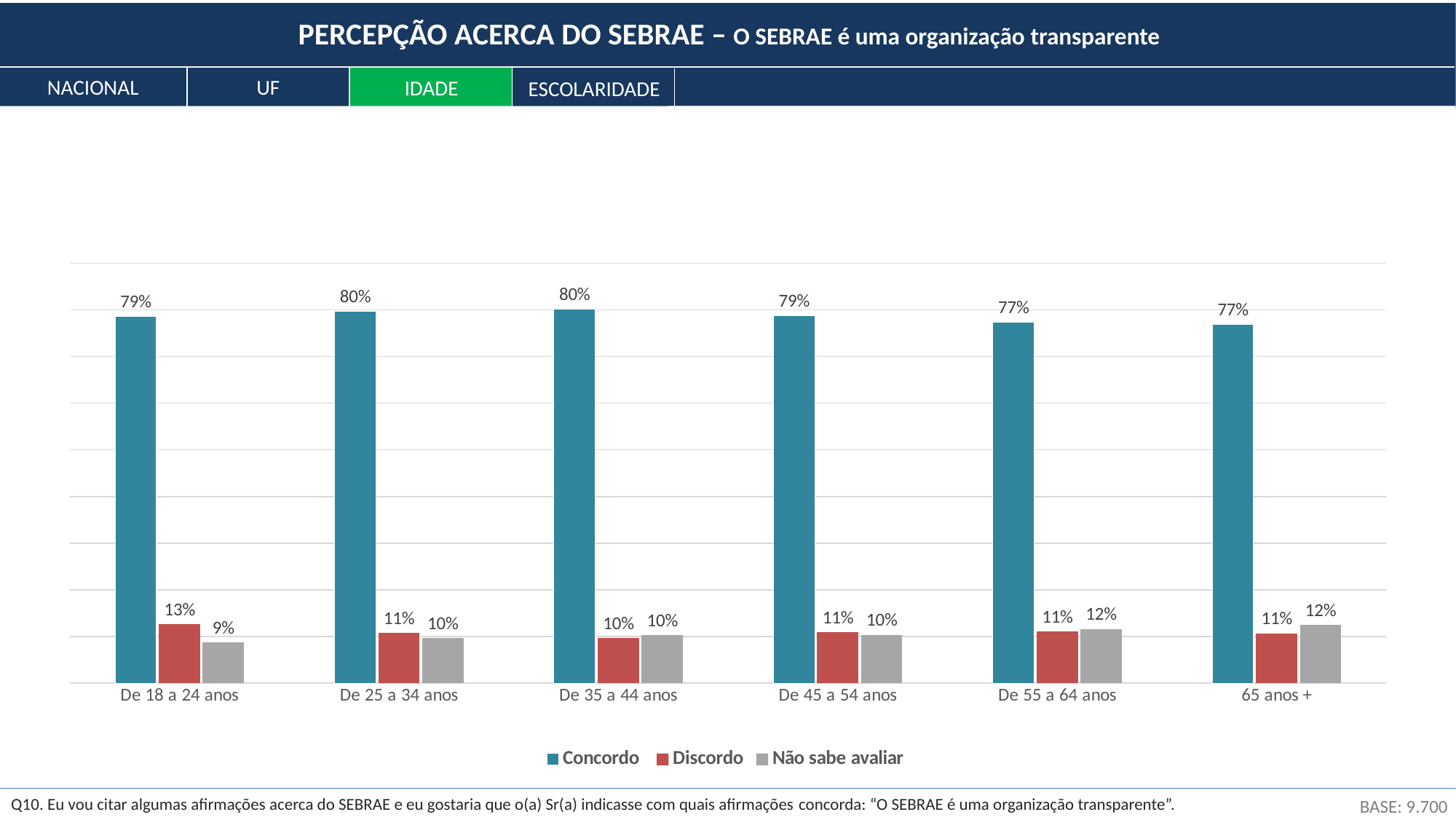
What is the Concordo value for De 55 a 64 anos? 77% Which age group has the highest Discordo value? De 18 a 24 anos Which age group has the lowest Não sabe avaliar value? De 18 a 24 anos Which is larger for De 45 a 54 anos: Discordo or Não sabe avaliar? Discordo What is the Não sabe avaliar value for 65 anos +? 12% How many age groups are shown on the x axis? 6 Which tab is highlighted in green above the chart? IDADE What is the Discordo value for De 18 a 24 anos? 13% How many series does the legend list? 3 What kind of chart is shown on the slide? Bar chart What is the Concordo value for De 18 a 24 anos? 79% What is the difference between the Concordo values for De 35 a 44 anos and 65 anos +? 3%